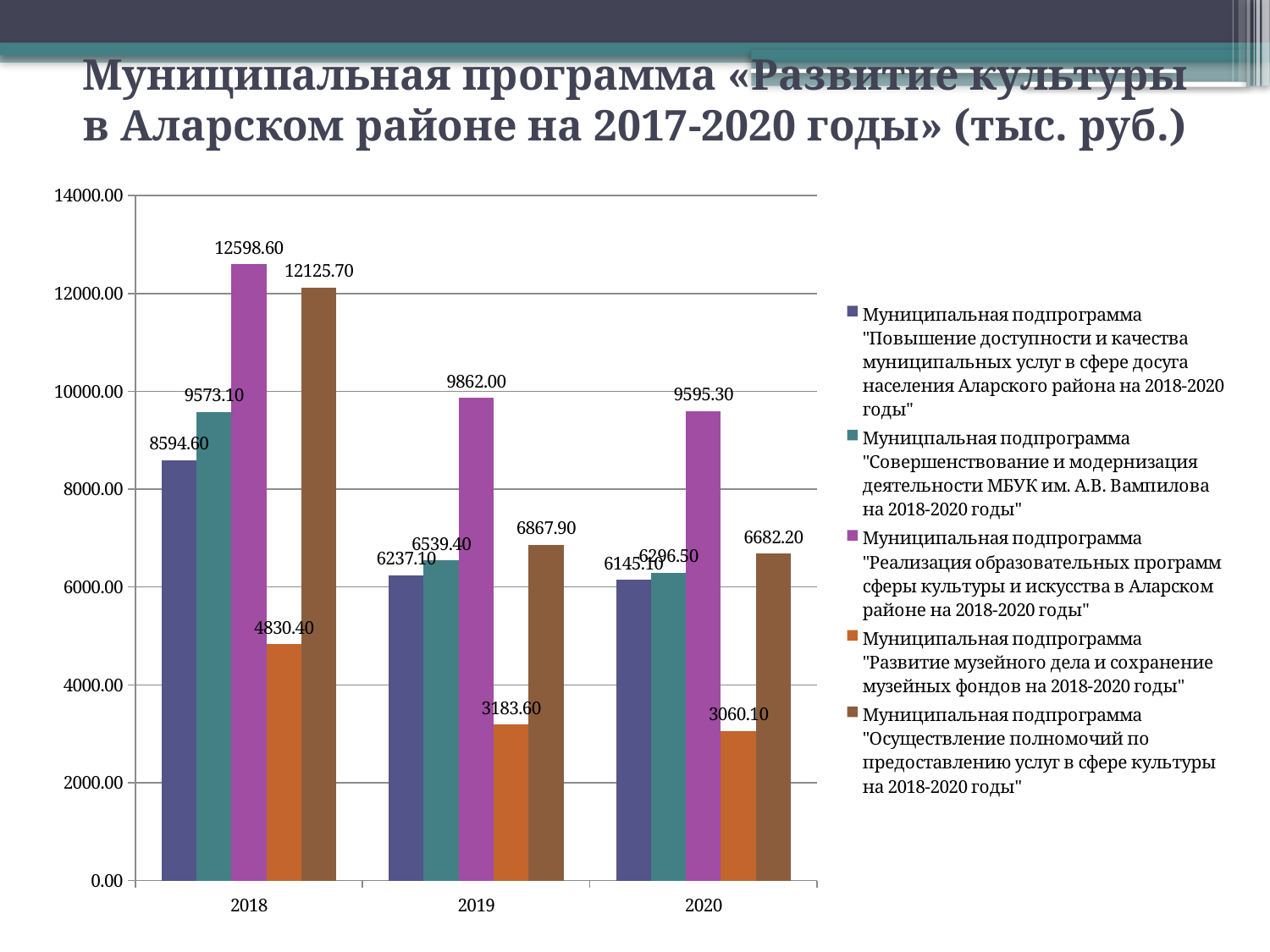
Which is larger in 2019: the value for "Совершенствование и модернизация деятельности МБУК им. А.В. Вампилова" or for "Осуществление полномочий по предоставлению услуг в сфере культуры"? Осуществление полномочий по предоставлению услуг в сфере культуры Does the value for the subprogram "Развитие музейного дела и сохранение музейных фондов" in 2018 rise or fall from 2018 to 2020? fall What is the value for the subprogram "Реализация образовательных программ сферы культуры и искусства" in 2018? 12598.60 Is the value for the subprogram "Осуществление полномочий по предоставлению услуг в сфере культуры" in 2018 greater or less than 12000.00? greater How many series does the legend list? 5 How many year categories are shown on the x axis? 3 Which year has the highest value for the subprogram "Повышение доступности и качества муниципальных услуг в сфере досуга населения"? 2018 What type of chart is shown on the slide? bar chart What is the value for the subprogram "Развитие музейного дела и сохранение музейных фондов" in 2019? 3183.60 What is the value for the subprogram "Осуществление полномочий по предоставлению услуг в сфере культуры" in 2020? 6682.20 Which subprogram has the lowest value in 2020? Развитие музейного дела и сохранение музейных фондов What is the difference between the 2018 and 2019 values for the subprogram "Реализация образовательных программ сферы культуры и искусства"? 2736.60